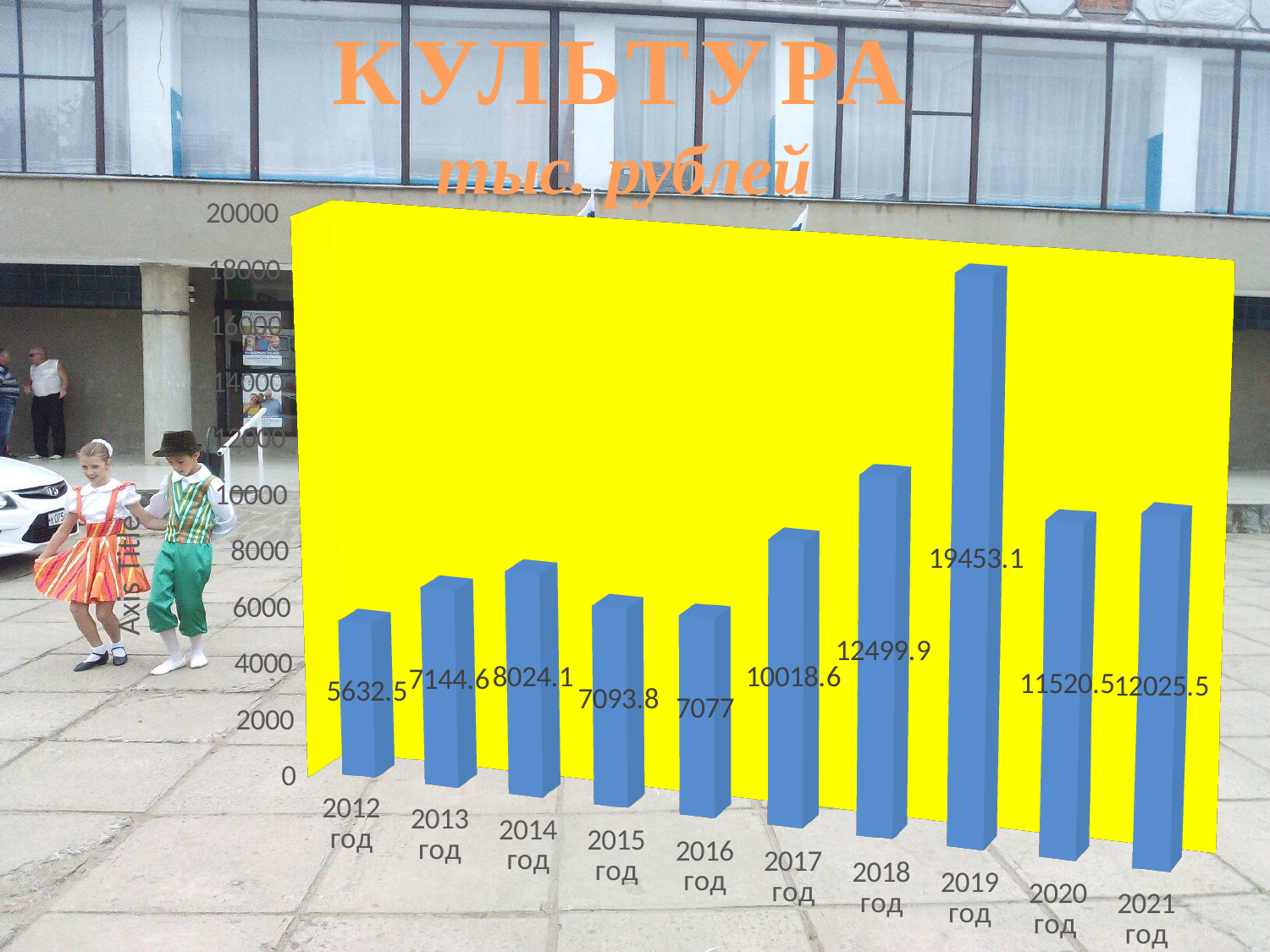
What is the value for 2012 год? 5632.5 What kind of chart is shown on the slide? bar chart Which year has the lowest value? 2012 год What is the difference between the values for 2019 год and 2018 год? 6953.2 Which is larger, the value for 2021 год or the value for 2020 год? 2021 год What is the title of the chart? КУЛЬТУРА тыс. рублей Is the value for 2018 год greater or less than 12000? greater Do the values rise or fall from 2012 год to 2014 год? rise How many years are shown on the x axis? 10 Which year has the highest value? 2019 год What is the value for 2017 год? 10018.6 What is the value for 2019 год? 19453.1